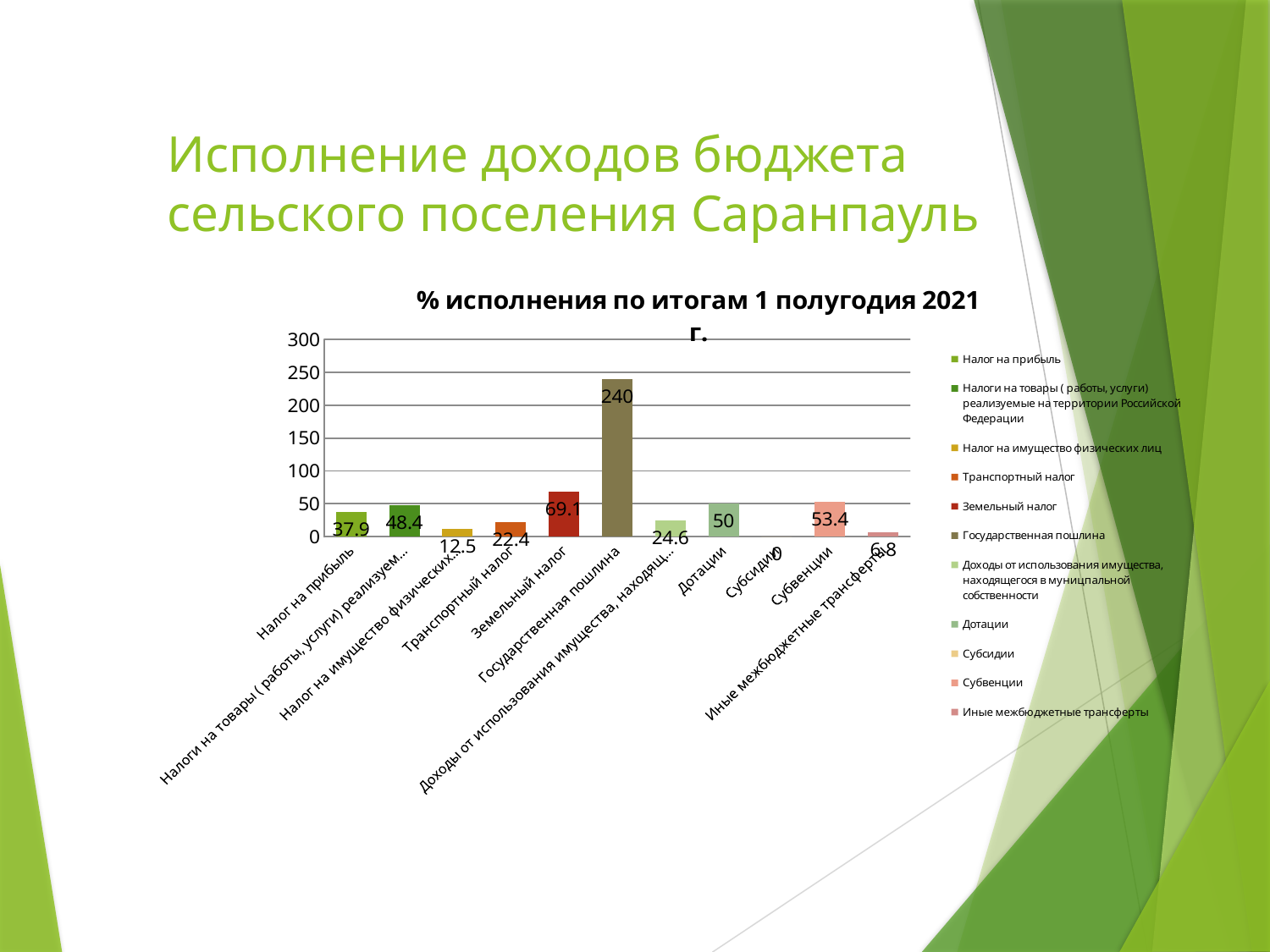
What is the difference between the values for Субвенции and Дотации? 3.4 Which category has the highest value? Государственная пошлина What is the value for Земельный налог? 69.1 What is the value for Государственная пошлина? 240 What is the value for Субвенции? 53.4 Which category has the lowest value? Субсидии How many entries does the legend list? 11 Which is larger, the value for Транспортный налог or the value for Налог на имущество физических лиц? Транспортный налог What kind of chart is shown? Bar chart What is the title of the chart? % исполнения по итогам 1 полугодия 2021 г. What is the value for Налог на прибыль? 37.9 How many categories are shown on the x axis? 11